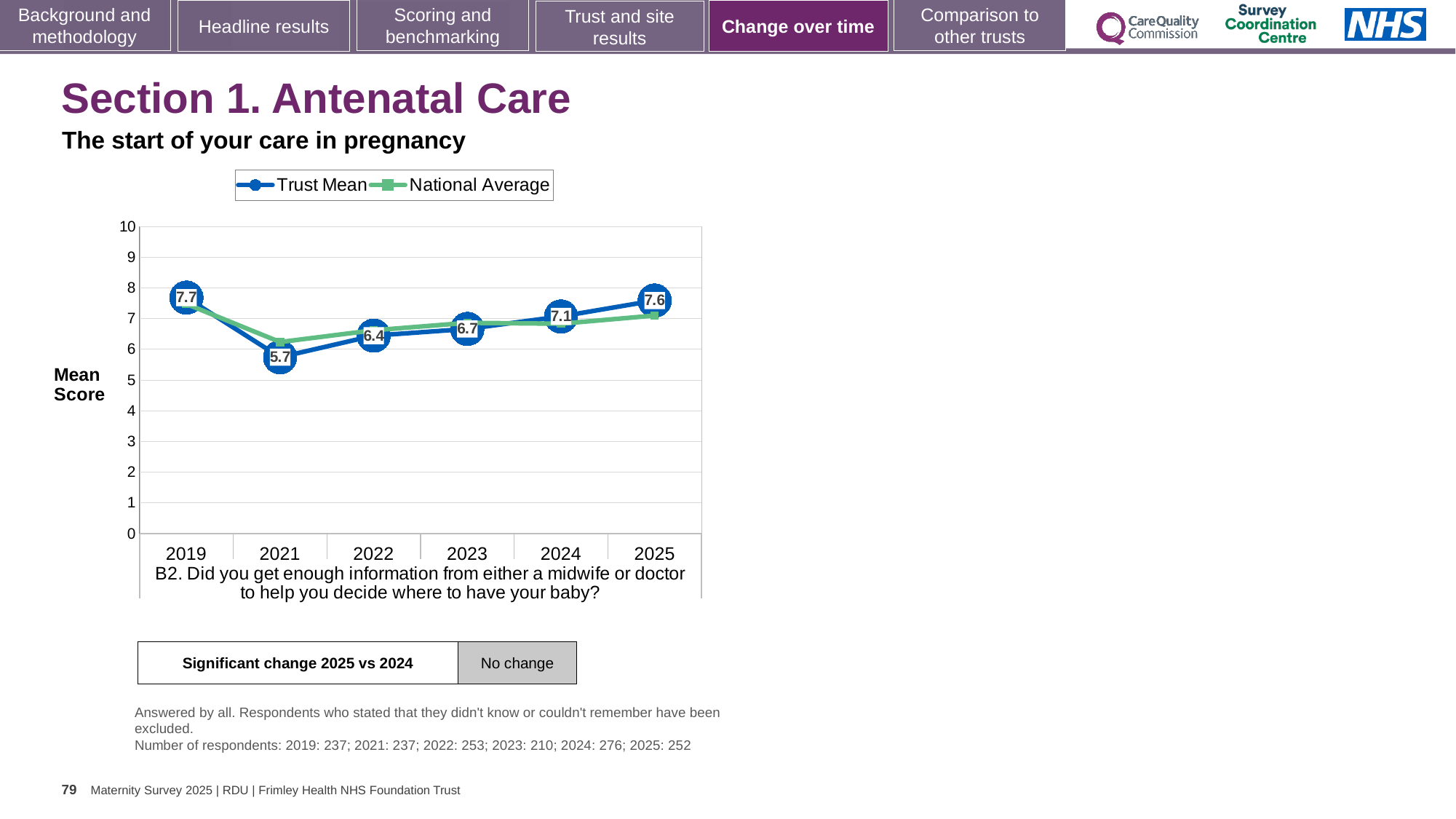
What is the Trust Mean score for 2023? 6.7 What is the difference between the Trust Mean in 2019 and in 2021? 2.0 What kind of chart is shown? Line chart In which year is the Trust Mean highest? 2019 What is the Trust Mean score for 2025? 7.6 How many series does the legend list? 2 Which year has the larger Trust Mean, 2024 or 2025? 2025 What is the Trust Mean score for 2021? 5.7 How many years are shown on the x axis? 6 Is the National Average for 2019 greater or less than 7? greater Does the Trust Mean rise or fall from 2021 to 2025? Rise In which year is the Trust Mean lowest? 2021